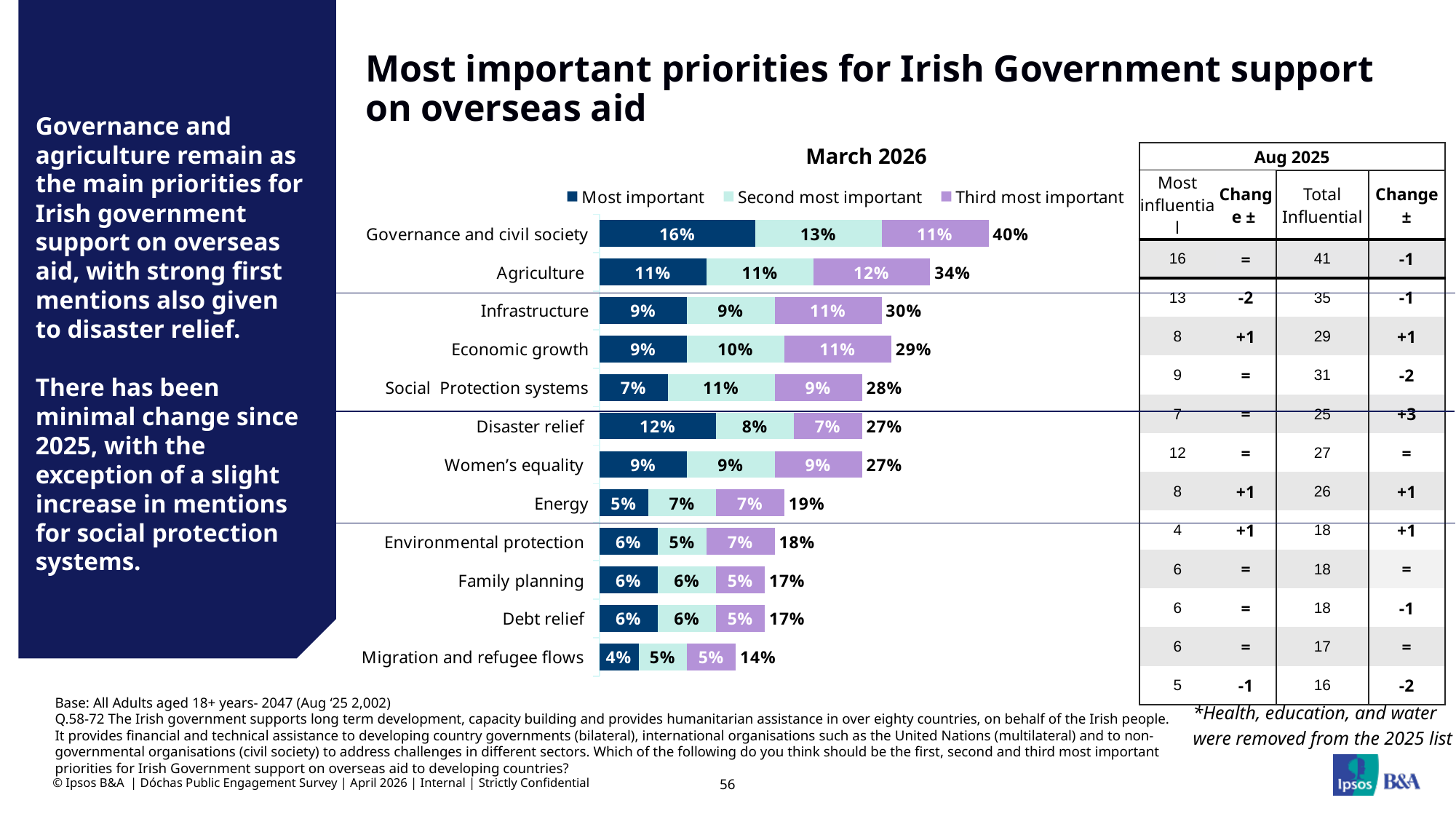
What is the 'Third most important' value for Agriculture? 12% What type of chart is shown on the slide? Stacked bar chart What is the 'Second most important' value for Social Protection systems? 11% Which category has the lowest total across the three stacked segments? Migration and refugee flows What is the total of the stacked bar for Disaster relief? 27% What period does the chart title above the bars refer to? March 2026 How many series does the chart legend list? 3 What is the 'Most important' value for Governance and civil society? 16% Which has a larger 'Most important' value, Disaster relief or Infrastructure? Disaster relief How many categories are shown in the chart? 12 Which category has the highest total across the three stacked segments? Governance and civil society What is the difference between the 'Most important' values for Governance and civil society and Agriculture? 5%